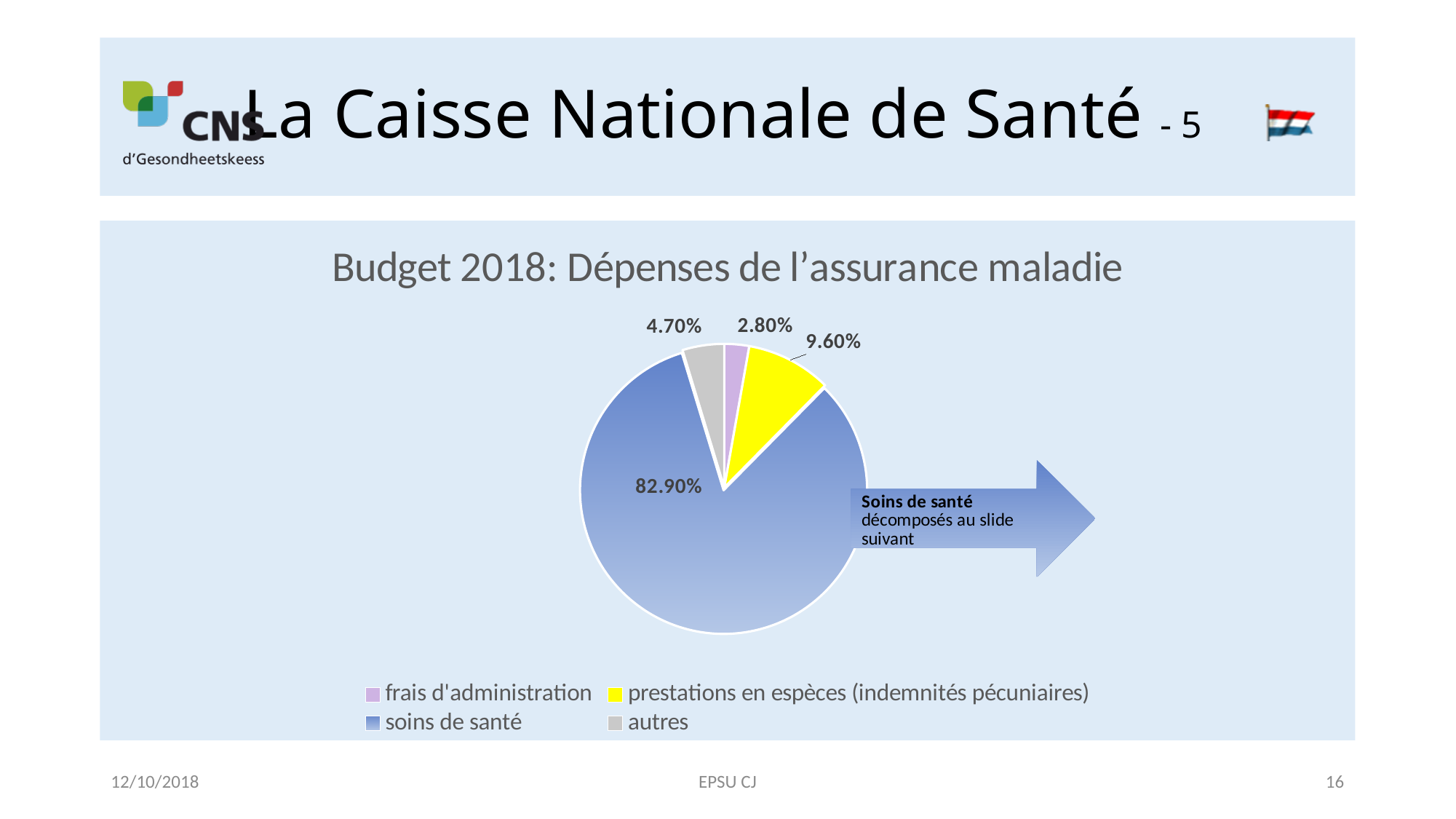
What is the title of the chart? Budget 2018: Dépenses de l'assurance maladie What share of the pie is 'autres'? 4.70% What share of the pie is 'prestations en espèces (indemnités pécuniaires)'? 9.60% Which colour represents 'prestations en espèces (indemnités pécuniaires)' in the pie chart? yellow What share of the pie is 'soins de santé'? 82.90% What is the difference between the shares of 'soins de santé' and 'prestations en espèces (indemnités pécuniaires)'? 73.30% What type of chart is shown on the slide? pie chart Which is larger, 'autres' or 'frais d'administration'? autres What share of the pie is 'frais d'administration'? 2.80% Which category has the smallest slice of the pie? frais d'administration Which category has the largest slice of the pie? soins de santé How many categories does the pie chart show? 4